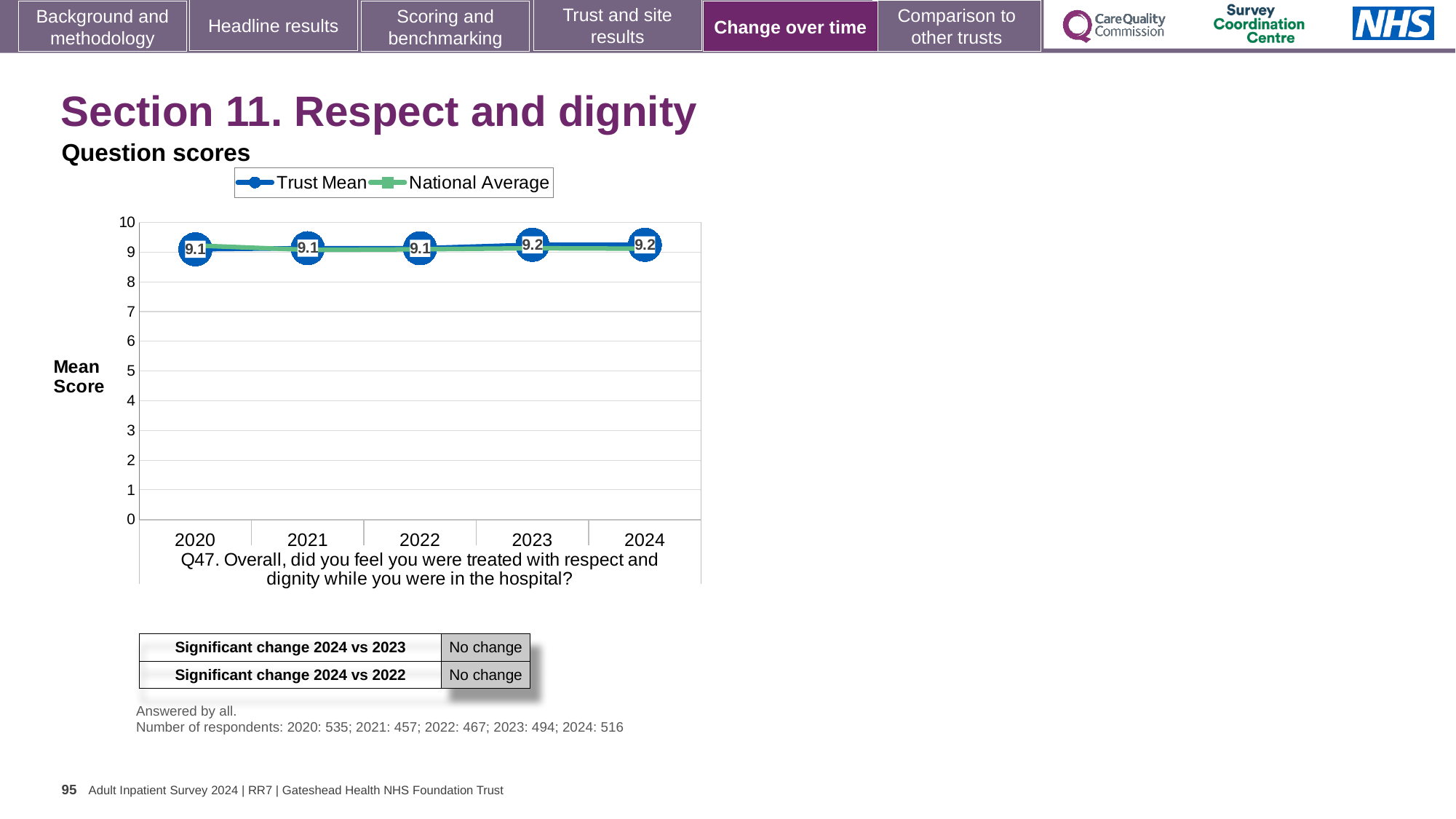
What is the Trust Mean score for 2022? 9.1 Is the National Average value for 2022 greater or less than 8? greater How many years are plotted on the x axis of the chart? 5 What is the Trust Mean score for 2024? 9.2 What is the Trust Mean score for 2023? 9.2 How many series does the chart legend list? 2 What are the two series named in the chart legend? Trust Mean and National Average What kind of chart is shown on the slide? line chart Does the Trust Mean rise or fall from 2020 to 2024? rise What is the Trust Mean score for 2020? 9.1 Which year has the larger Trust Mean, 2021 or 2023? 2023 What is the difference between the Trust Mean in 2024 and in 2020? 0.1